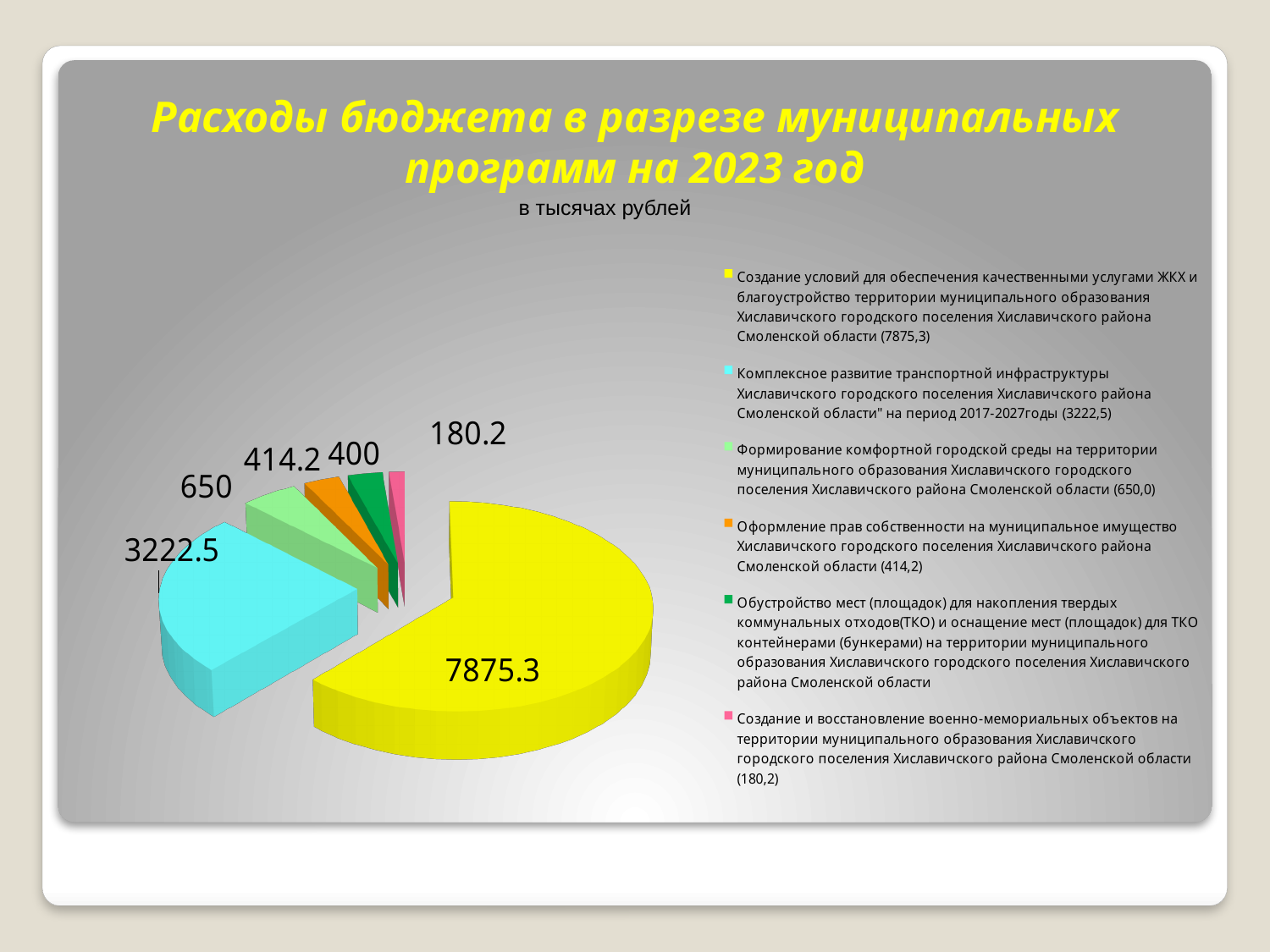
What is the value of the smallest slice in the pie chart? 180.2 What value is shown for the cyan slice (Комплексное развитие транспортной инфраструктуры)? 3222.5 How many entries does the legend list? 6 What type of chart is shown on the slide? Pie chart Which is larger: the orange slice (414.2) or the dark green slice (400)? The orange slice (414.2) What value is shown for the orange slice (Оформление прав собственности на муниципальное имущество)? 414.2 What is the value of the largest slice in the pie chart? 7875.3 How many slices does the pie chart have? 6 What value is shown for the dark green slice (Обустройство мест (площадок) для накопления ТКО)? 400 In what units are the values on the chart given, according to the subtitle? в тысячах рублей What is the difference between the largest slice (7875.3) and the second largest slice (3222.5)? 4652.8 What value is shown for the light green slice (Формирование комфортной городской среды)? 650